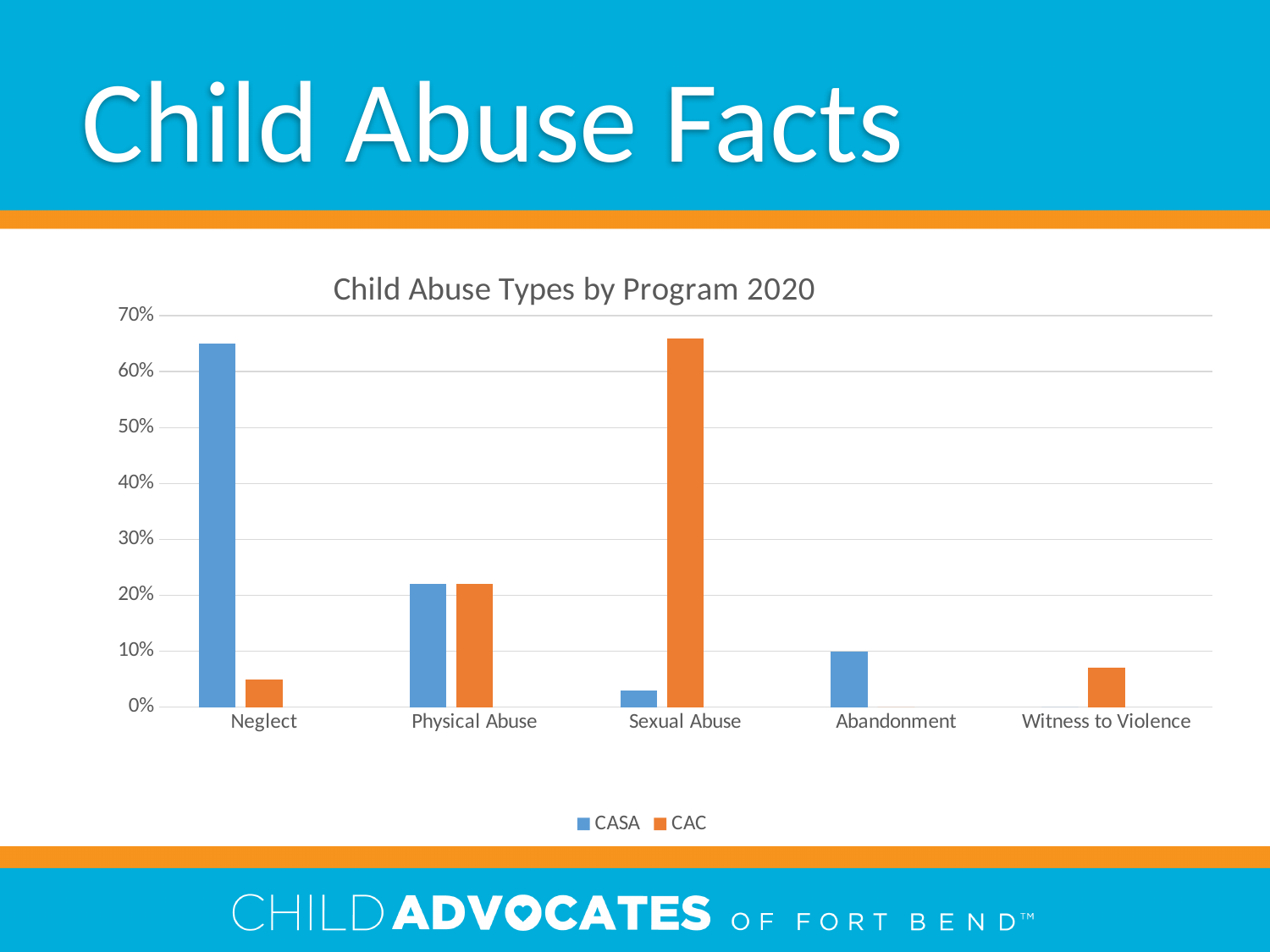
How many series does the legend list? 2 Which colour represents the CAC series in the legend? orange For Sexual Abuse, which program has the larger value, CASA or CAC? CAC Which category has the highest CASA value? Neglect Which category has the highest CAC value? Sexual Abuse How many abuse-type categories are shown on the x axis? 5 What is the title of the chart? Child Abuse Types by Program 2020 Is the CAC value for Sexual Abuse greater or less than 60%? greater Is the CAC value for Witness to Violence greater or less than 10%? less Is the CASA value for Neglect greater or less than 60%? greater What kind of chart is shown on the slide? bar chart For Neglect, which program has the larger value, CASA or CAC? CASA